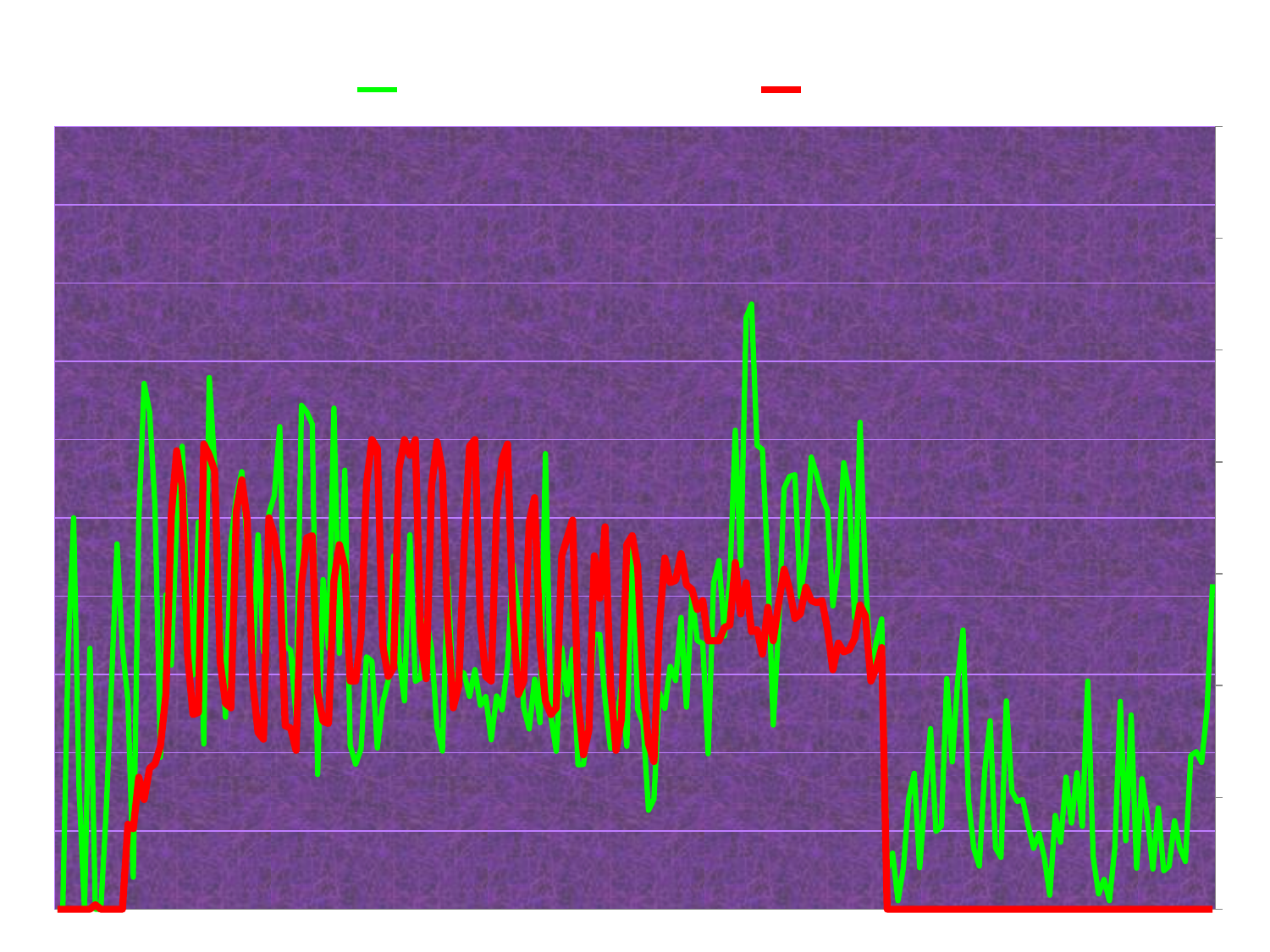
How many series does the legend list? 2 Which line, green or red, stays flat along the bottom of the chart in the right-hand portion? red Does the red line end at the right edge of the chart higher or lower than its level in the middle of the chart? lower Which line, green or red, reaches the highest peak on the chart? green What kind of chart is shown on the slide? line chart What colours are the two lines plotted on the chart? green and red